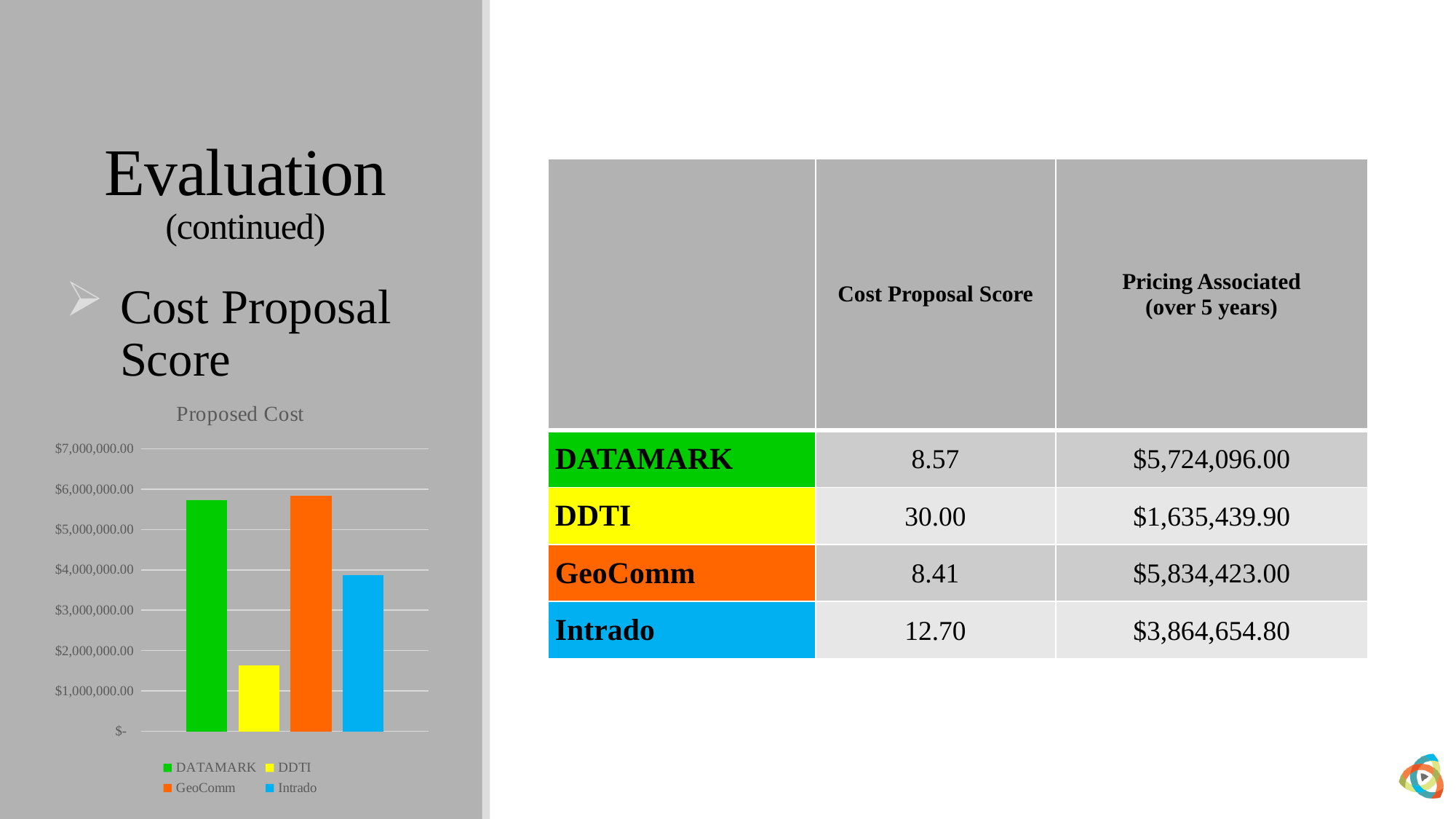
What kind of chart is the "Proposed Cost" chart? bar chart In the "Proposed Cost" chart, is the value for DATAMARK greater or less than $5,000,000.00? greater What is the proposed cost for Intrado shown on the slide? $3,864,654.80 What colour is the bar for GeoComm in the "Proposed Cost" chart? orange In the "Proposed Cost" chart, is the value for DDTI greater or less than $2,000,000.00? less What is the proposed cost for DDTI shown on the slide? $1,635,439.90 Which vendor has the lowest bar in the "Proposed Cost" chart? DDTI How many entries does the legend of the "Proposed Cost" chart list? 4 How many bars are plotted in the "Proposed Cost" chart? 4 In the "Proposed Cost" chart, is the value for Intrado greater or less than $4,000,000.00? less In the "Proposed Cost" chart, is the bar for DATAMARK or Intrado taller? DATAMARK In the "Proposed Cost" chart, is the bar for GeoComm or DDTI taller? GeoComm